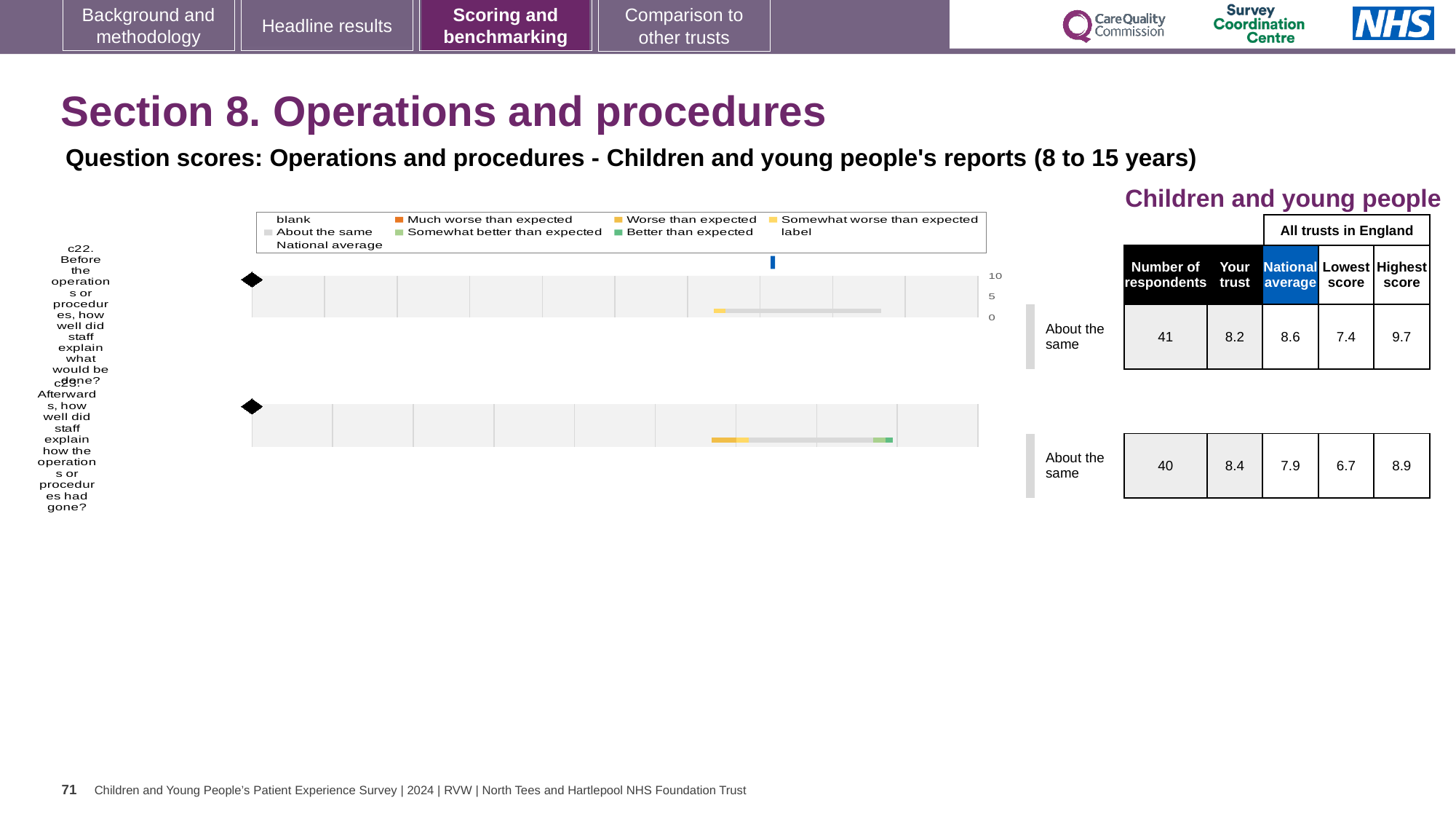
How many entries does the legend above the benchmarking charts list? 9 How many survey questions are plotted in the benchmarking charts on this slide? 2 In the table next to the charts, what is the Highest score among all trusts in England for c23? 8.9 In the table next to the charts, what is the 'Your trust' score for c22 (Before the operations or procedures, how well did staff explain what would be done?)? 8.2 What is the difference between the Highest score and the Lowest score for question c22? 2.3 What kind of chart is used to show the benchmarking results for questions c22 and c23? bar chart According to the legend, which colour represents 'Much worse than expected'? orange For question c23, which is larger: the 'Your trust' score or the National average? Your trust For question c22, which is larger: the 'Your trust' score or the National average? National average What benchmark category is shown for both c22 and c23 in the label column beside the charts? About the same In the table next to the charts, how many respondents answered question c22? 41 In the table next to the charts, what is the National average for c23 (Afterwards, how well did staff explain how the operations or procedures had gone?)? 7.9